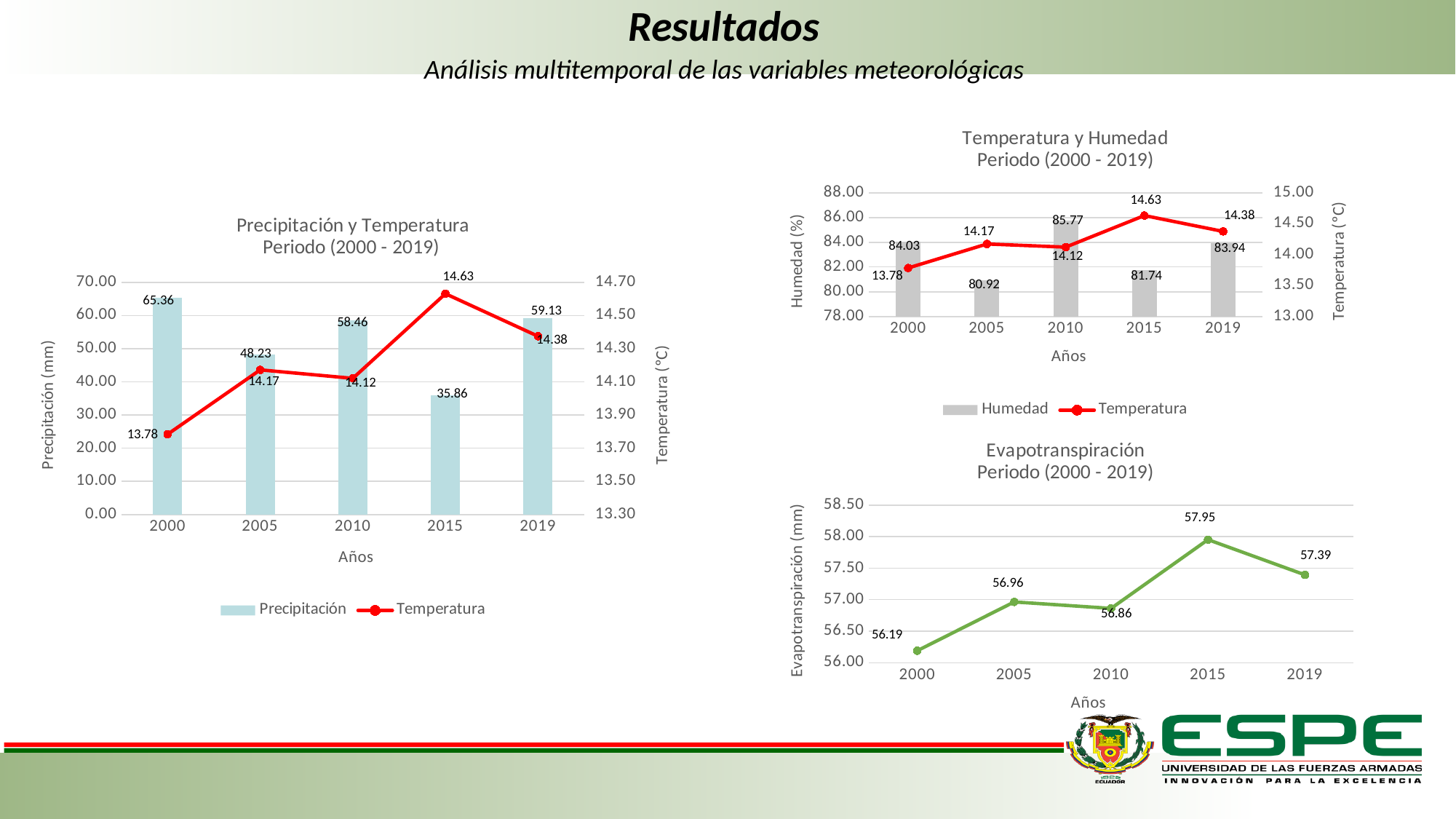
In the 'Temperatura y Humedad' chart, is the humidity in 2005 greater or less than 82.00? less In the 'Evapotranspiración' chart, what is the value for 2019? 57.39 In the 'Evapotranspiración' chart, is the value for 2005 larger than the value for 2010? Yes In the 'Temperatura y Humedad' chart, which year has the highest temperature? 2015 In the 'Precipitación y Temperatura' chart, what is the precipitation value for 2000? 65.36 In the 'Temperatura y Humedad' chart, what is the humidity value for 2010? 85.77 In the 'Precipitación y Temperatura' chart, which year has the lowest precipitation? 2015 In the 'Precipitación y Temperatura' chart, what is the difference between the precipitation in 2000 and in 2015? 29.50 What kind of chart is the 'Evapotranspiración' chart? Line chart In the 'Evapotranspiración' chart, which year has the highest evapotranspiration? 2015 In the 'Precipitación y Temperatura' chart, how many series does the legend list? 2 In the 'Temperatura y Humedad' chart, which year has the lowest humidity? 2005